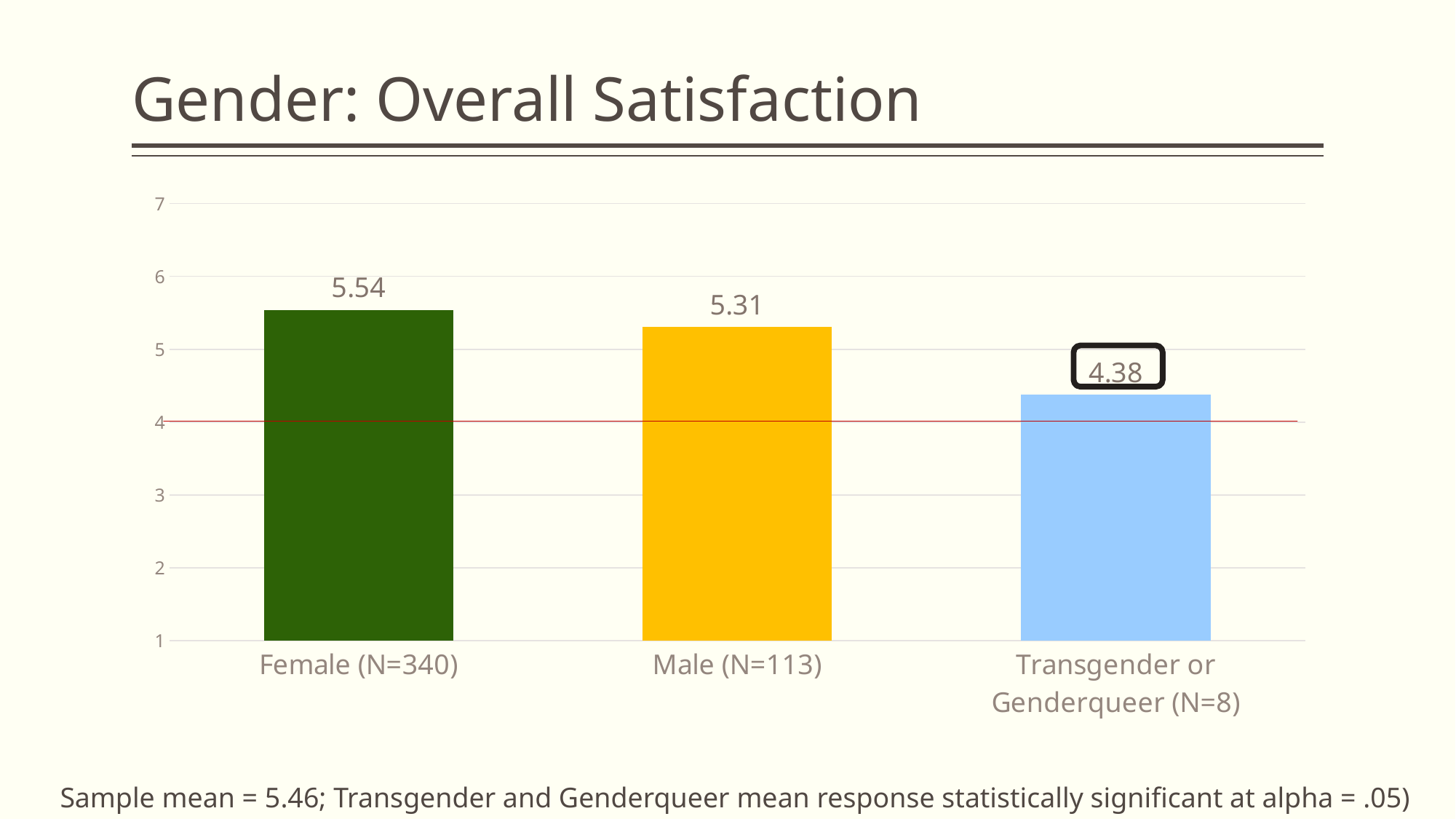
What is the difference between the Male and Transgender or Genderqueer overall satisfaction values? 0.93 What is the overall satisfaction value for Male (N=113)? 5.31 What kind of chart is shown on the slide? Bar chart What is the overall satisfaction value for Transgender or Genderqueer (N=8)? 4.38 Which gender category has the highest overall satisfaction? Female (N=340) What is the title of the slide? Gender: Overall Satisfaction Is the value for Transgender or Genderqueer greater or less than 5? less Which gender category has the lowest overall satisfaction? Transgender or Genderqueer (N=8) Which is larger, the value for Female or the value for Male? Female What is the overall satisfaction value for Female (N=340)? 5.54 What is the difference between the Female and Male overall satisfaction values? 0.23 How many gender categories are shown in the chart? 3